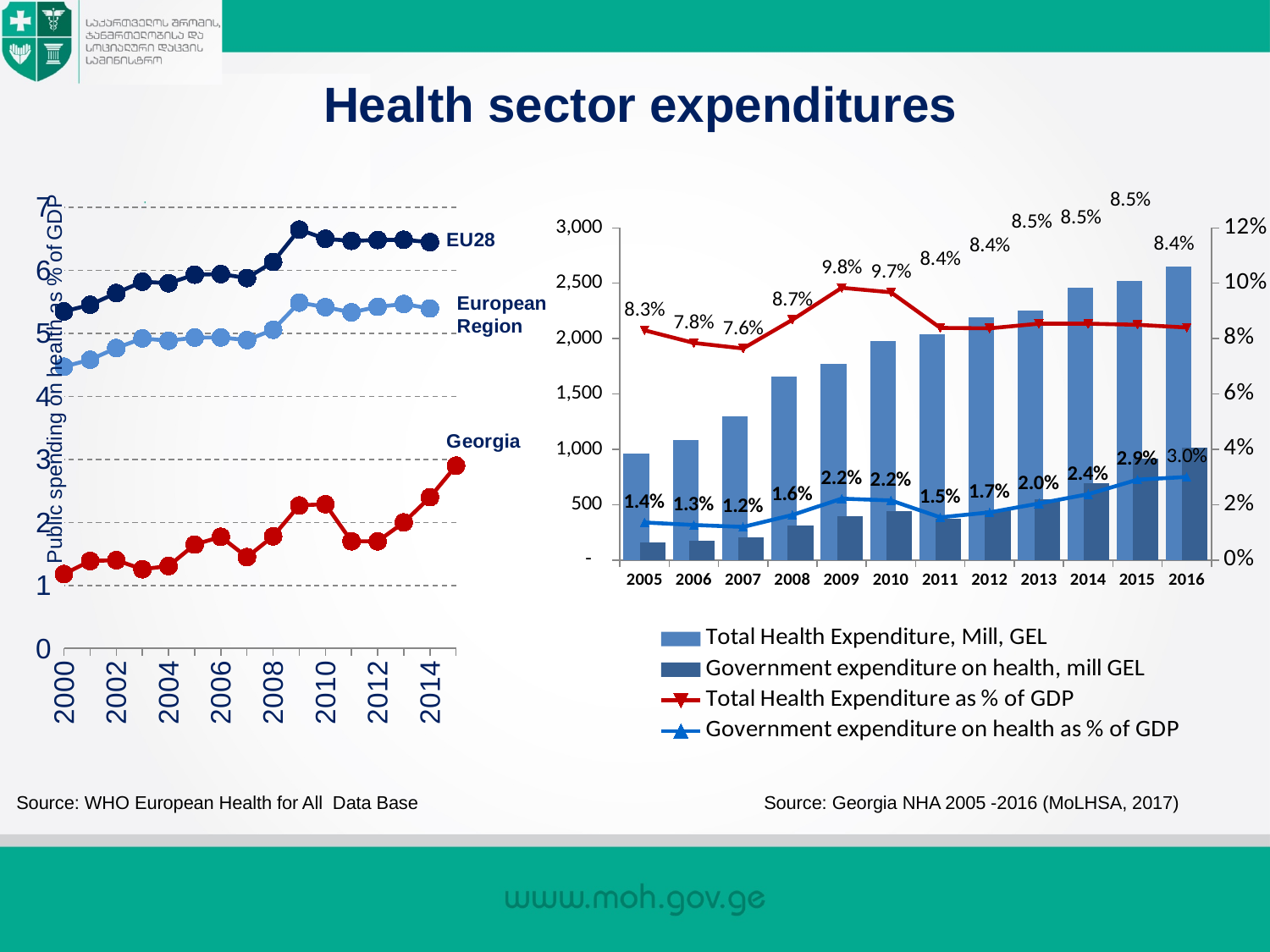
On the right chart, is the Total Health Expenditure, Mill, GEL bar for 2005 greater or less than 1,000? less On the left chart, is the value for Georgia in 2014 greater or less than 3? less How many series does the legend of the right chart list? 4 On the right chart, what is the Government expenditure on health as % of GDP in 2016? 3.0% On the right chart, in which year is Government expenditure on health as % of GDP highest? 2016 On the right chart, what is the Total Health Expenditure as % of GDP in 2009? 9.8% On the right chart, which is larger: Government expenditure on health as % of GDP in 2010 or in 2011? 2010 What kind of chart is the left chart? line chart On the right chart, what is the difference between Total Health Expenditure as % of GDP in 2009 and in 2007? 2.2% On the right chart, is the Total Health Expenditure, Mill, GEL bar for 2016 greater or less than 2,500? greater On the right chart, in which year is Total Health Expenditure as % of GDP lowest? 2007 How many years are shown on the x axis of the right chart? 12